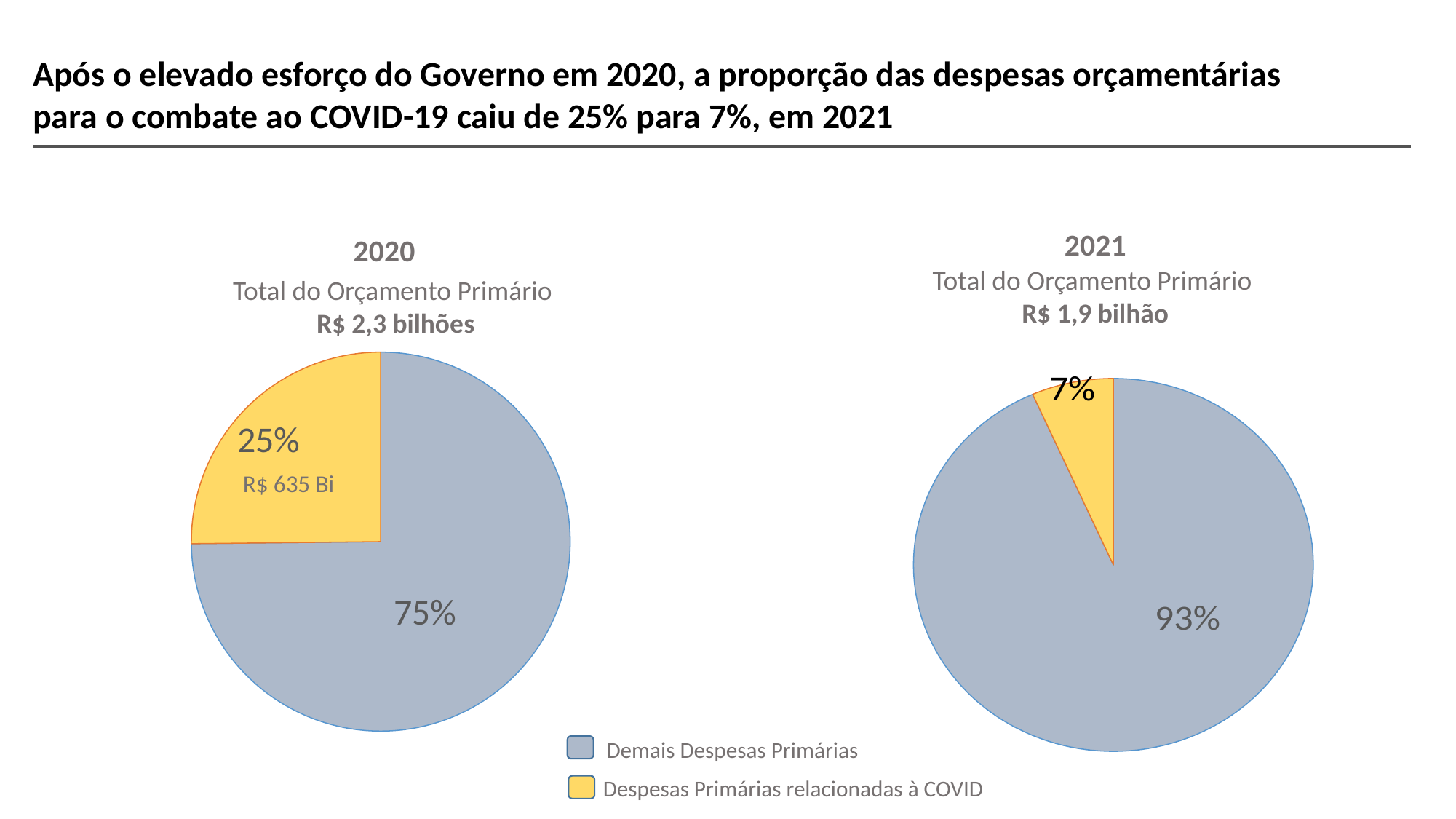
In the 2020 pie chart, what amount in reais is shown for the COVID-related slice? R$ 635 Bi In the 2021 pie chart, what share is Demais Despesas Primárias? 93% In the 2020 pie chart, what share is Demais Despesas Primárias? 75% Which colour represents Despesas Primárias relacionadas à COVID in the legend? Yellow In the 2020 pie chart, what share of the primary budget is Despesas Primárias relacionadas à COVID? 25% By how many percentage points did the COVID-related share fall from the 2020 pie chart to the 2021 pie chart? 18 percentage points What is the Total do Orçamento Primário shown above the 2021 pie chart? R$ 1,9 bilhão Which slice is larger in the 2021 pie chart, Demais Despesas Primárias or Despesas Primárias relacionadas à COVID? Demais Despesas Primárias How many slices does the 2020 pie chart have? 2 What type of chart is used for 2020 and 2021 on this slide? Pie chart What is the Total do Orçamento Primário shown above the 2020 pie chart? R$ 2,3 bilhões